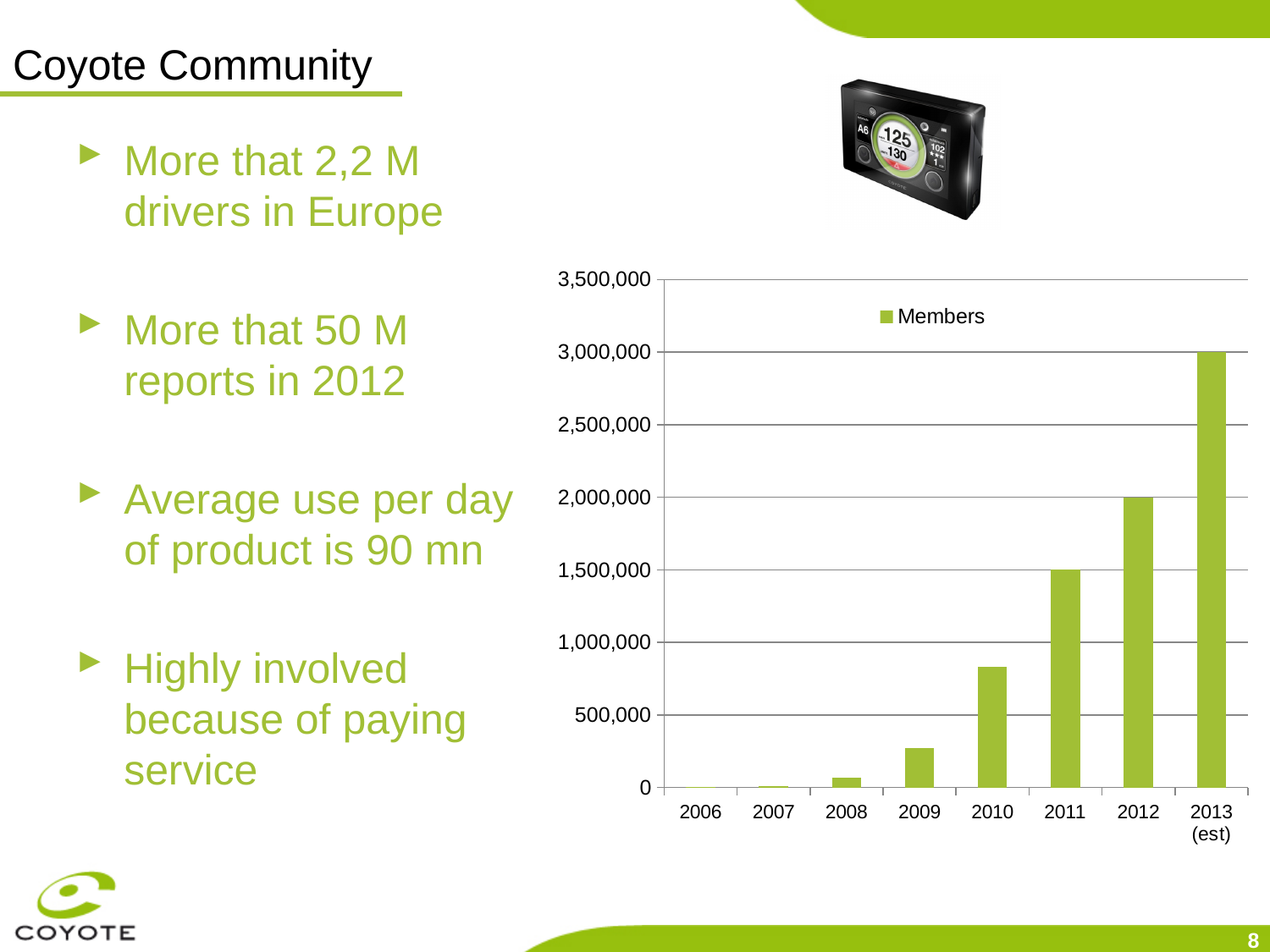
Is the value for 2010 greater or less than 1,000,000? less How many years are shown along the x axis of the chart? 8 Which year has more members, 2010 or 2011? 2011 What is the number of members for 2012? 2,000,000 What is the number of members for 2011? 1,500,000 What is the name of the series shown in the chart legend? Members How many series does the chart legend list? 1 Do the member values rise or fall from 2006 to 2013 (est)? rise What kind of chart is shown on the slide? bar chart What is the number of members for 2013 (est)? 3,000,000 Which year has the highest number of members in the chart? 2013 (est) Is the value for 2009 greater or less than 500,000? less